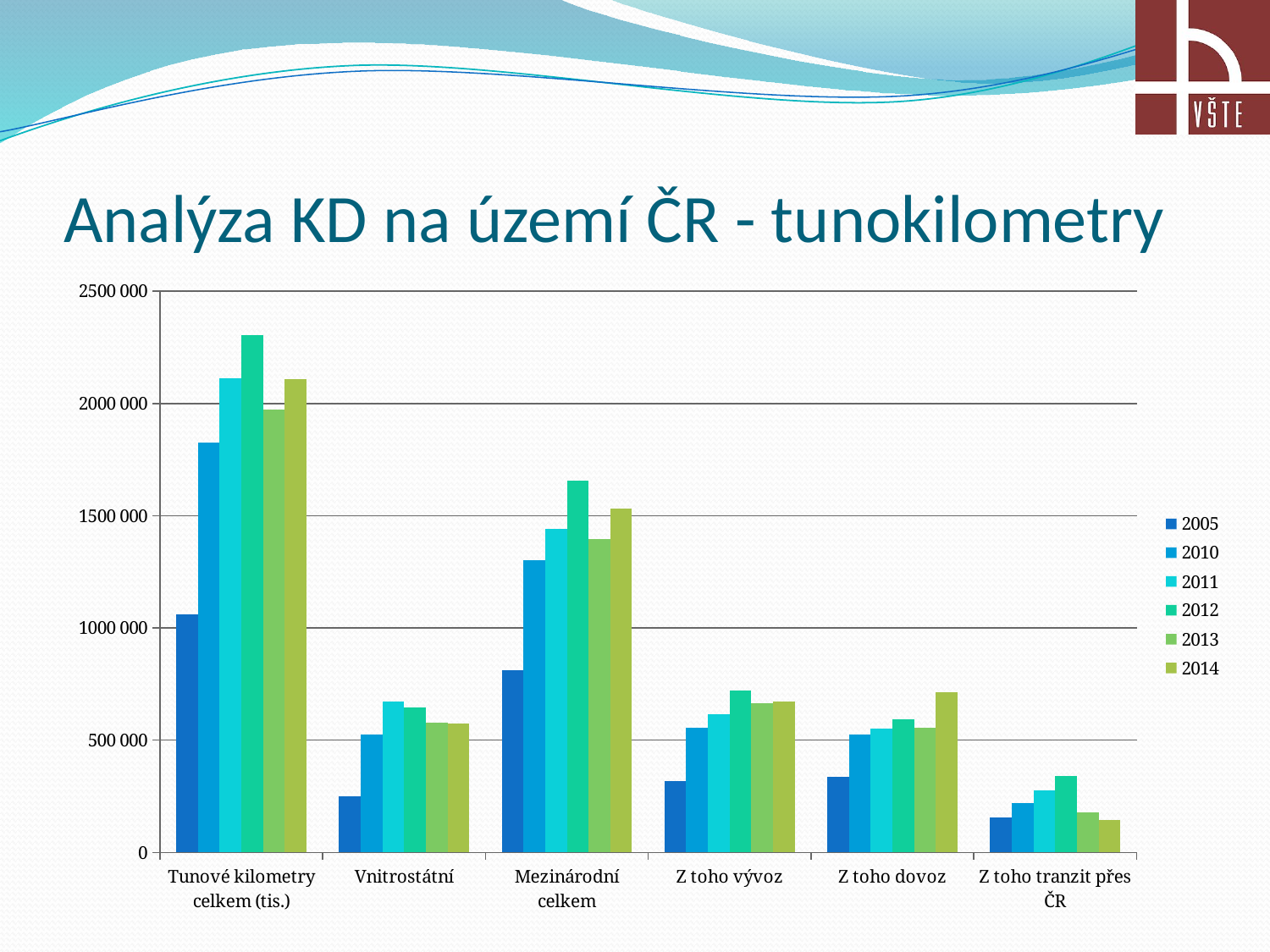
What is the title of the slide containing the chart? Analýza KD na území ČR - tunokilometry How many categories are shown along the x axis of the chart? 6 Is the value for 2012 in 'Mezinárodní celkem' greater or less than 1500 000? greater Is the value for 2005 in 'Vnitrostátní' greater or less than 500 000? less How many series does the legend list? 6 For the category 'Tunové kilometry celkem (tis.)', which year has the highest bar? 2012 For the category 'Z toho tranzit přes ČR', which year has the highest bar? 2012 Is the value for 2005 in 'Tunové kilometry celkem (tis.)' greater or less than 1000 000? greater For the category 'Tunové kilometry celkem (tis.)', which year has the lowest bar? 2005 For the category 'Z toho dovoz', which year has the highest bar? 2014 What kind of chart is shown on the slide? bar chart In the category 'Z toho dovoz', which is larger: the value for 2014 or the value for 2005? 2014